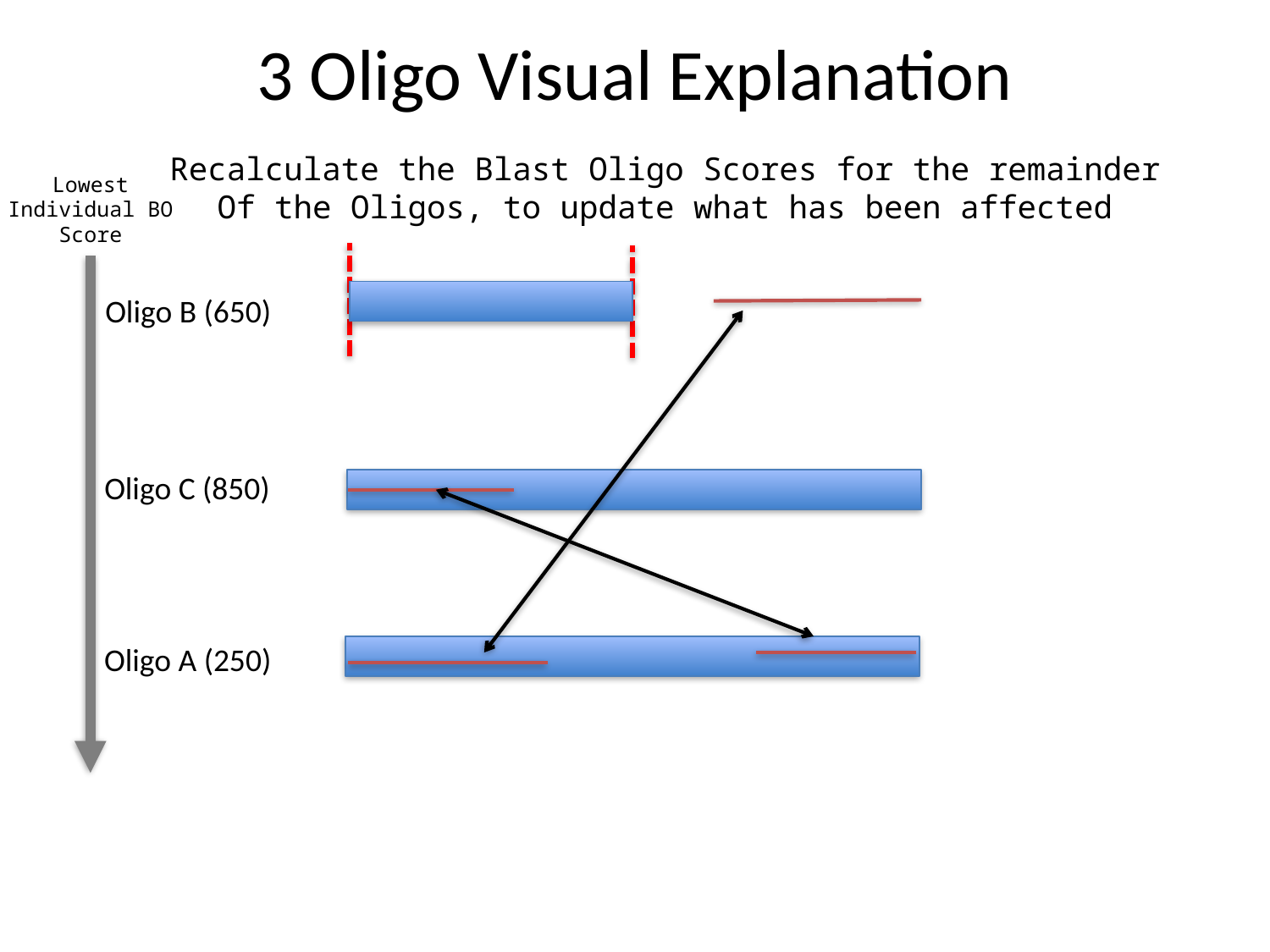
What is the title of the slide? 3 Oligo Visual Explanation What does the vertical grey arrow on the left represent? Lowest Individual BO Score What score is shown for Oligo C? 850 How many oligos are shown in the diagram? 3 What score is shown for Oligo B? 650 Which oligo has the highest score? Oligo C What is the difference between the scores of Oligo C and Oligo A? 600 What score is shown for Oligo A? 250 Which oligo has the lowest score? Oligo A Which has a higher score, Oligo B or Oligo A? Oligo B What is the difference between the scores of Oligo C and Oligo B? 200